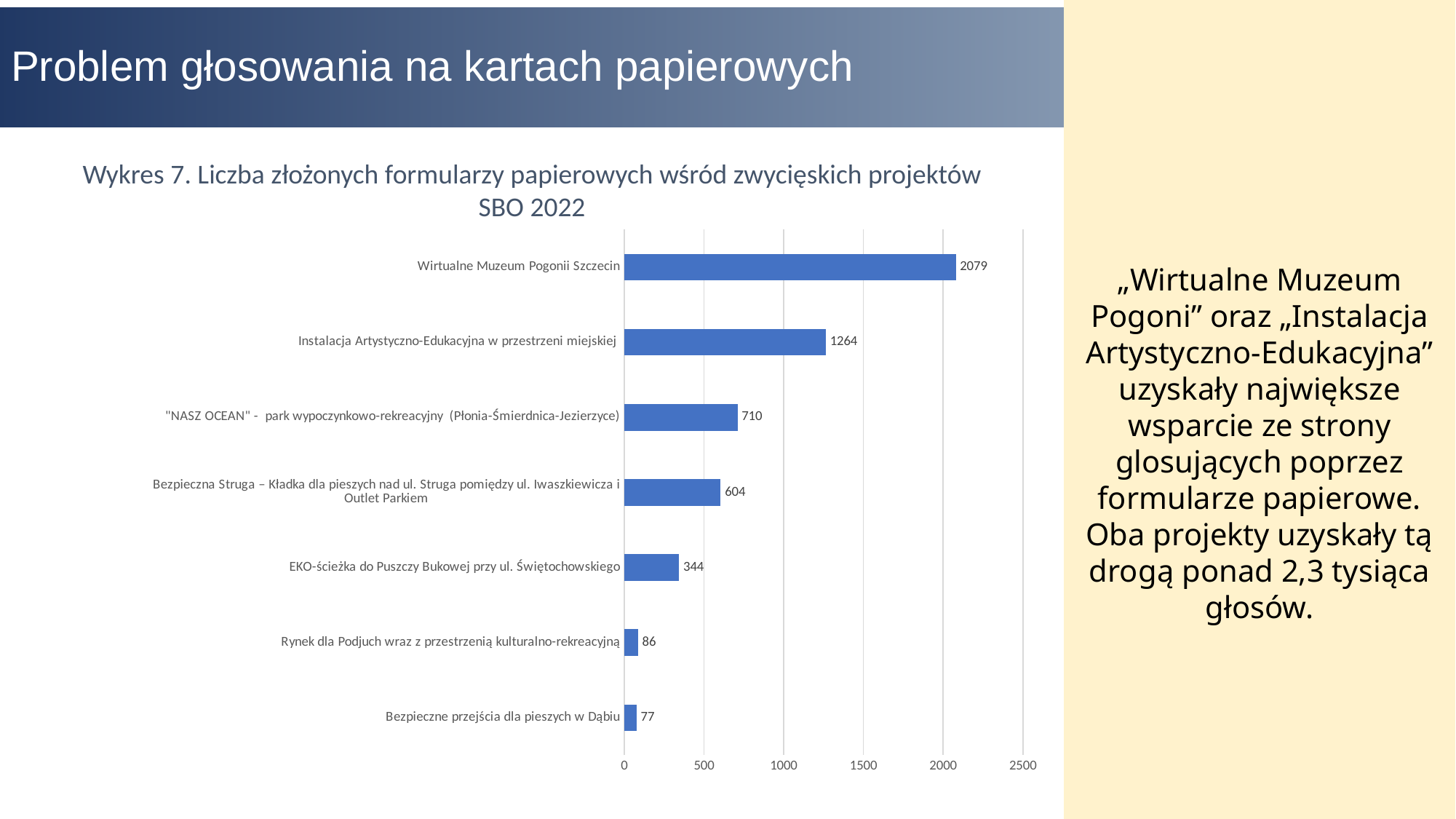
How many paper forms were submitted for Wirtualne Muzeum Pogonii Szczecin? 2079 Which project has the lowest number of paper forms? Bezpieczne przejścia dla pieszych w Dąbiu Which project has the highest number of paper forms? Wirtualne Muzeum Pogonii Szczecin Is the value for "NASZ OCEAN" greater or less than 500? greater What is the value for EKO-ścieżka do Puszczy Bukowej przy ul. Świętochowskiego? 344 What is the value for Instalacja Artystyczno-Edukacyjna w przestrzeni miejskiej? 1264 Which has a larger value: Rynek dla Podjuch or Bezpieczne przejścia dla pieszych w Dąbiu? Rynek dla Podjuch What is the difference between the values for "NASZ OCEAN" and Bezpieczna Struga? 106 How many projects are shown in the chart? 7 What type of chart is shown on the slide? Bar chart What is the title of the chart? Wykres 7. Liczba złożonych formularzy papierowych wśród zwycięskich projektów SBO 2022 What is the difference between the values for Wirtualne Muzeum Pogonii Szczecin and Instalacja Artystyczno-Edukacyjna w przestrzeni miejskiej? 815